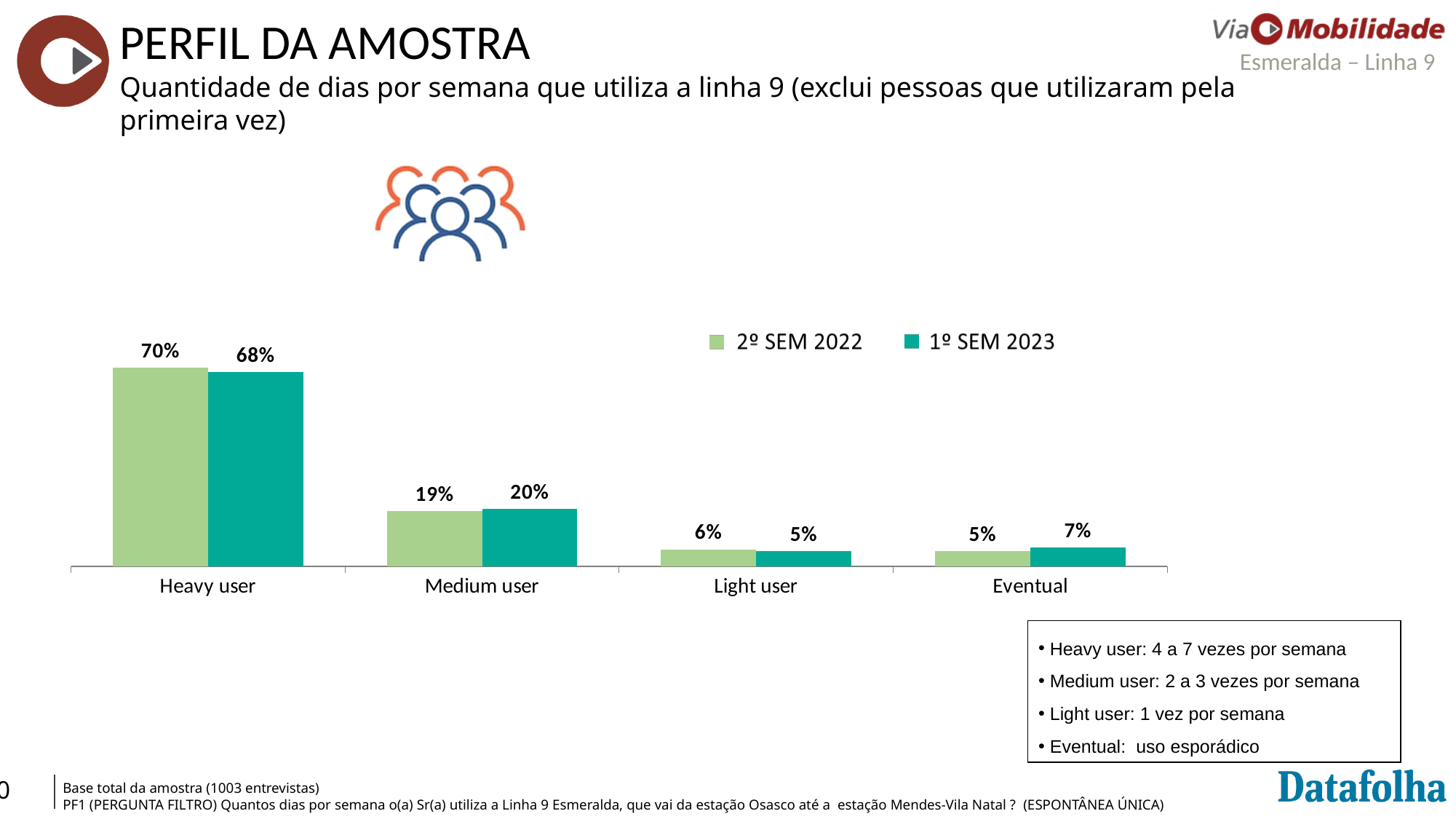
How many series does the legend list? 2 What is the value for Eventual in the 1º SEM 2023 series? 7% Which category has the highest value in the 1º SEM 2023 series? Heavy user How many categories are shown on the x axis? 4 What is the value for Medium user in the 1º SEM 2023 series? 20% What are the two series names listed in the legend? 2º SEM 2022 and 1º SEM 2023 What kind of chart is shown on the slide? Bar chart Which category has the lowest value in the 2º SEM 2022 series? Eventual For Eventual, which series has the larger value: 2º SEM 2022 or 1º SEM 2023? 1º SEM 2023 What is the value for Light user in the 2º SEM 2022 series? 6% What is the value for Heavy user in the 2º SEM 2022 series? 70% What is the difference between the 2º SEM 2022 and 1º SEM 2023 values for Heavy user? 2%